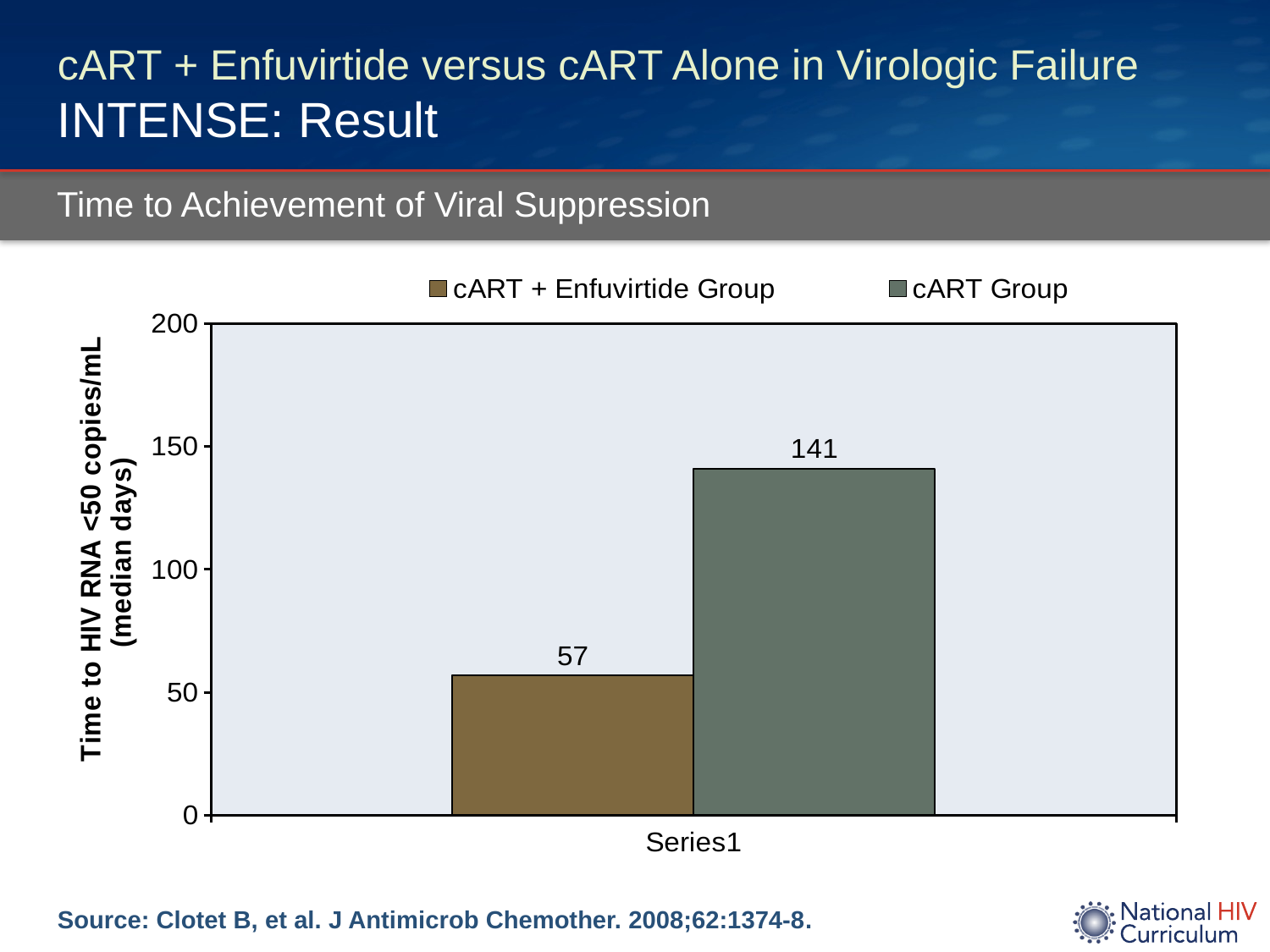
Is the value for the cART Group greater or less than 100? greater What kind of chart is shown on the slide? bar chart Which group has the higher median time to HIV RNA <50 copies/mL? cART Group What is the difference in median days between the cART Group and the cART + Enfuvirtide Group? 84 What is the maximum value shown on the y axis? 200 Which group has the lower median time to HIV RNA <50 copies/mL? cART + Enfuvirtide Group What is the value for the cART + Enfuvirtide Group? 57 What is the value for the cART Group? 141 How many series does the legend list? 2 What is the label of the y axis? Time to HIV RNA <50 copies/mL (median days) Is the value for the cART + Enfuvirtide Group larger or smaller than the value for the cART Group? smaller Is the value for the cART + Enfuvirtide Group greater or less than 100? less